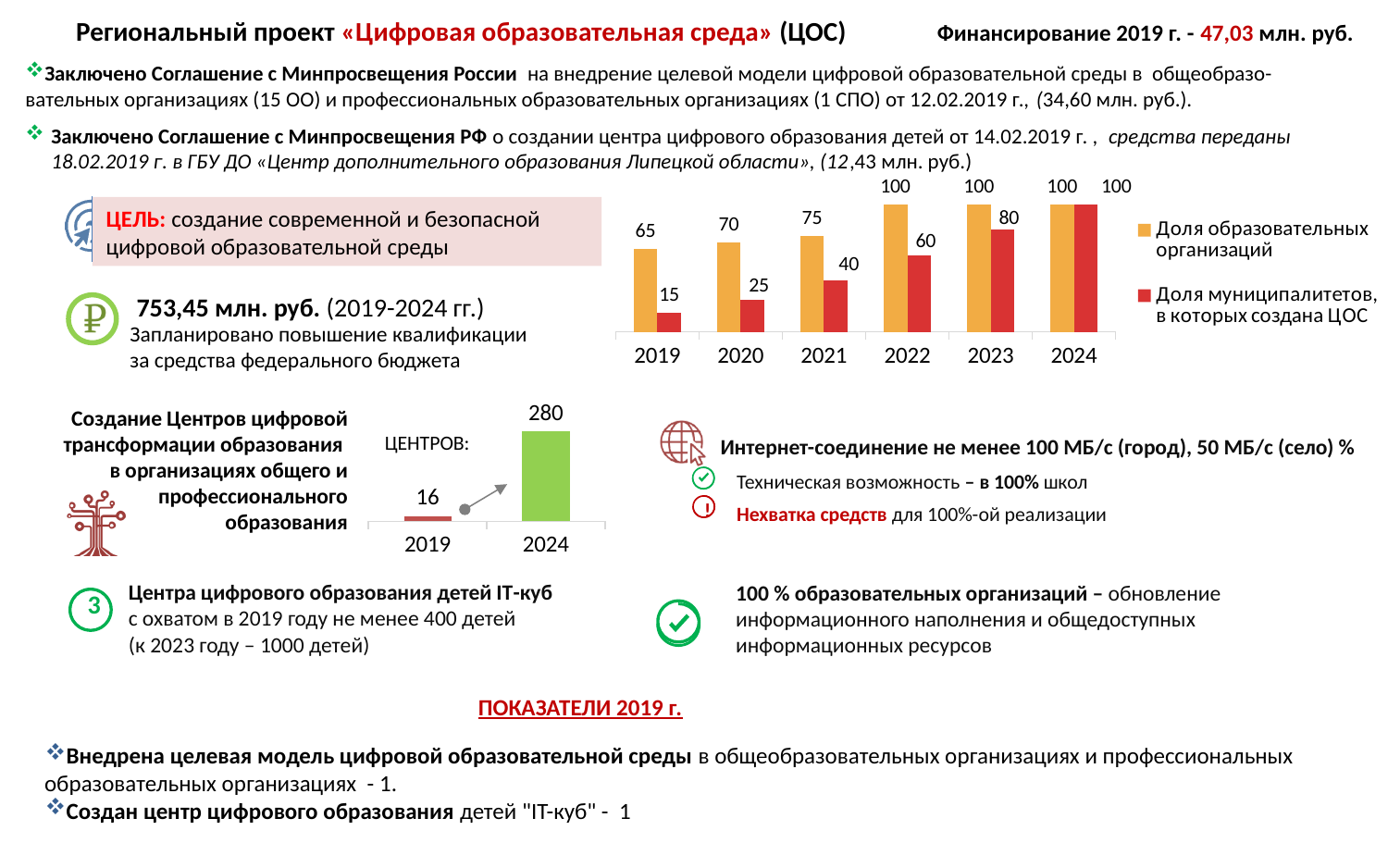
What kind of chart is the top-right chart? bar chart In the top-right bar chart, which year has the lowest value for 'Доля муниципалитетов, в которых создана ЦОС'? 2019 In the top-right bar chart, what is the value of 'Доля муниципалитетов, в которых создана ЦОС' for 2023? 80 In the bottom-left 'ЦЕНТРОВ:' chart, what is the difference between the 2024 and 2019 values? 264 In the top-right bar chart, do the values for 'Доля муниципалитетов, в которых создана ЦОС' rise or fall from 2019 to 2024? rise In the top-right bar chart, how many series does the legend list? 2 In the top-right bar chart, what is the value of 'Доля образовательных организаций' for 2019? 65 In the bottom-left 'ЦЕНТРОВ:' chart, what is the value for 2024? 280 In the top-right bar chart, what is the value of 'Доля муниципалитетов, в которых создана ЦОС' for 2021? 40 In the top-right bar chart, how many years are shown on the x axis? 6 In the top-right bar chart, which is larger in 2020: 'Доля образовательных организаций' or 'Доля муниципалитетов, в которых создана ЦОС'? Доля образовательных организаций In the top-right bar chart, what is the difference between 'Доля образовательных организаций' and 'Доля муниципалитетов, в которых создана ЦОС' in 2022? 40